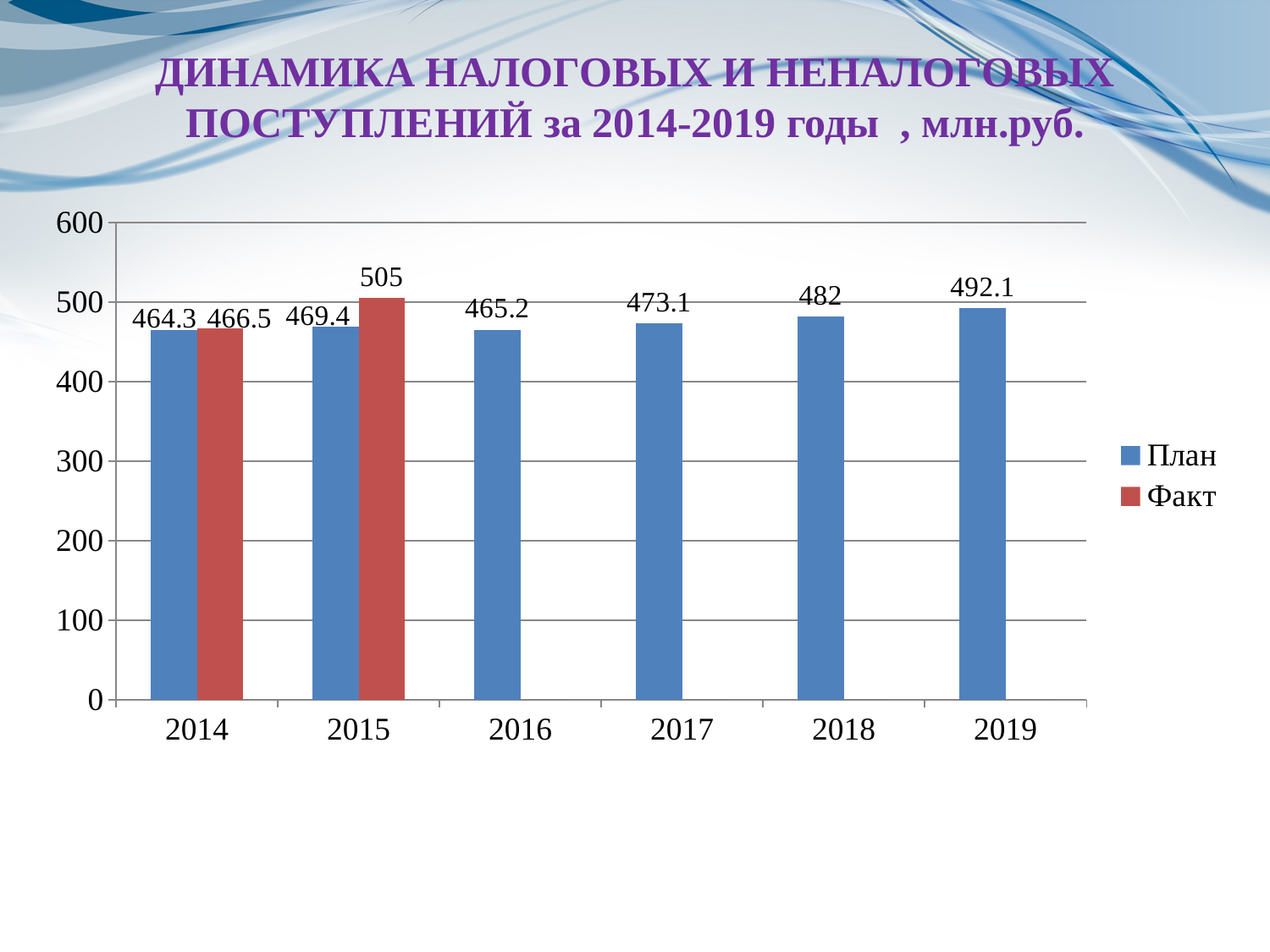
What is the План value for 2014? 464.3 Which year has the lowest План value? 2014 How many years are shown on the x axis? 6 Which year has the highest План value? 2019 Which is larger, the План value for 2017 or the План value for 2018? 2018 What is the difference between the Факт and План values for 2015? 35.6 What is the Факт value for 2014? 466.5 What is the План value for 2019? 492.1 What is the Факт value for 2015? 505 What kind of chart is shown on the slide? bar chart How many series does the legend list? 2 Is the Факт value for 2015 greater or less than 500? greater